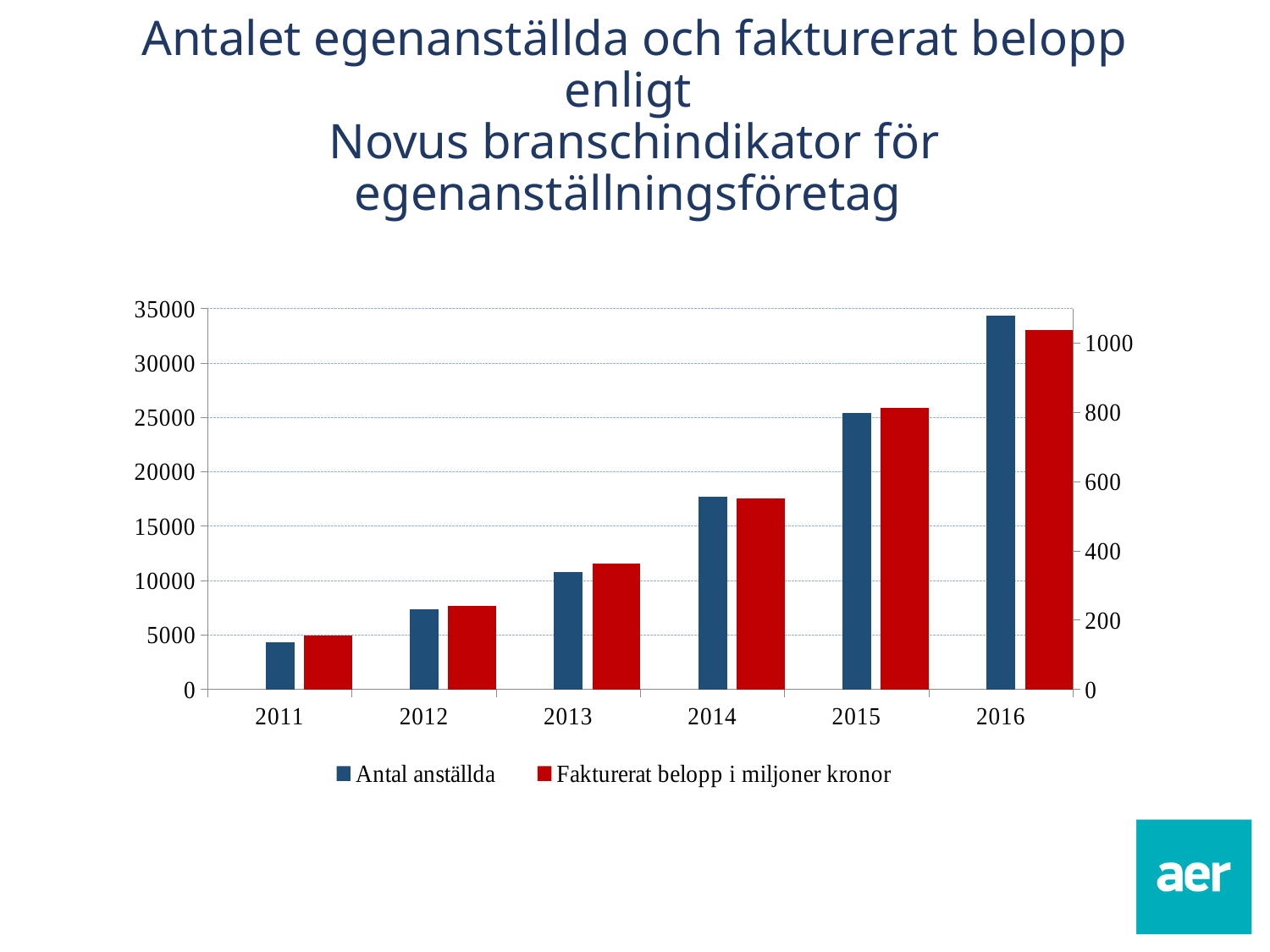
Is the value for Fakturerat belopp i miljoner kronor in 2014 greater or less than 600? less Which year has the lowest value for Fakturerat belopp i miljoner kronor? 2011 Is the value for Fakturerat belopp i miljoner kronor in 2011 greater or less than 200? less What kind of chart is shown on the slide? bar chart Which year has the larger value for Antal anställda, 2014 or 2015? 2015 Is the value for Antal anställda in 2014 greater or less than 20000? less How many series does the chart's legend list? 2 Which year has the highest value for Antal anställda? 2016 Do the values for Antal anställda rise or fall from 2011 to 2016? rise Which colour represents Fakturerat belopp i miljoner kronor in the chart? red How many years are shown on the x axis of the chart? 6